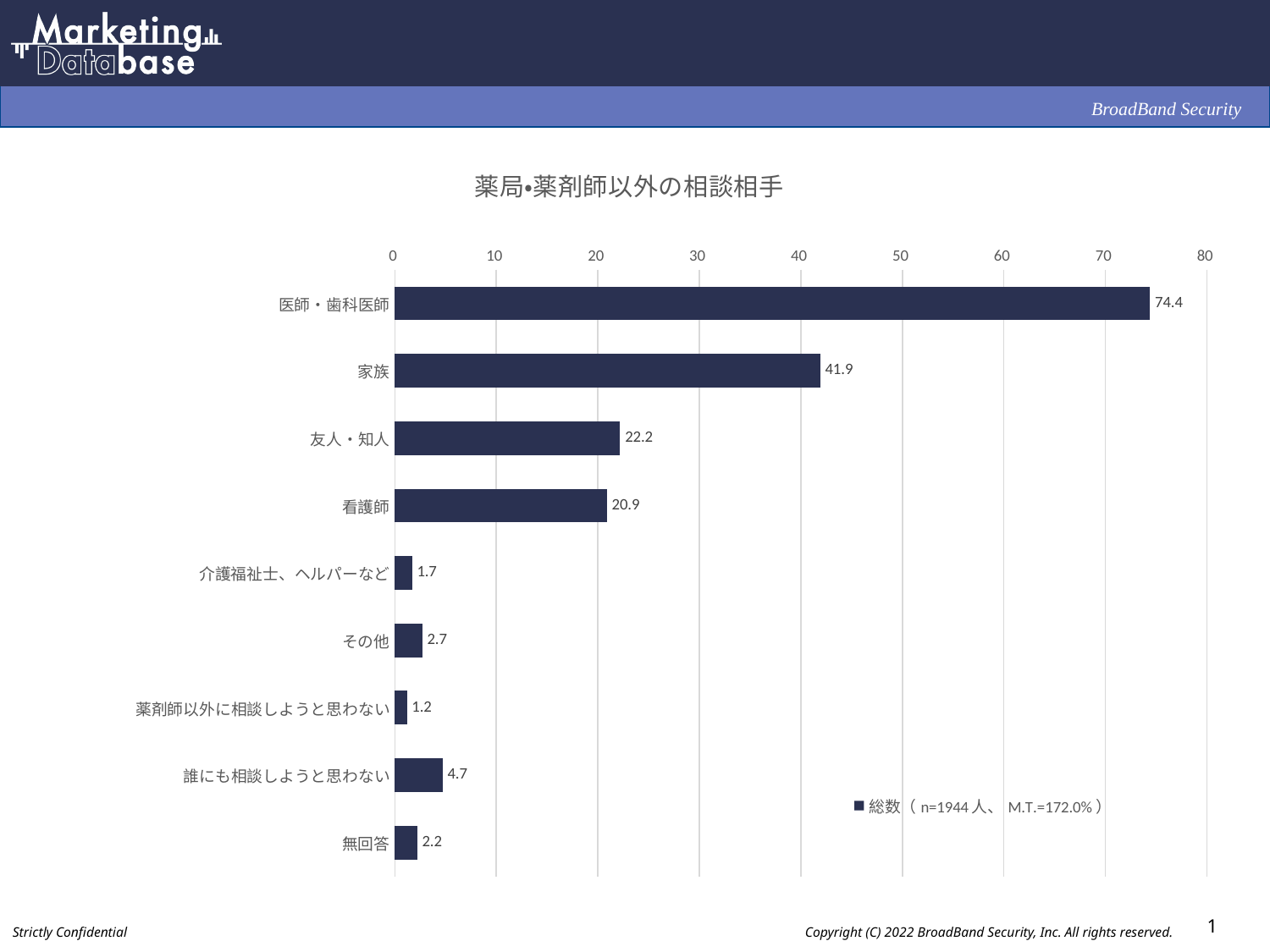
What is the difference between the values for 医師・歯科医師 and 家族? 32.5 What is the value for 誰にも相談しようと思わない? 4.7 Which category has the lowest value? 薬剤師以外に相談しようと思わない What is the value for 医師・歯科医師? 74.4 How many categories are shown in the chart? 9 Is the value for 家族 greater or less than 40? greater What kind of chart is shown on the slide? bar chart What is the value for 看護師? 20.9 Which is larger, the value for 友人・知人 or the value for 看護師? 友人・知人 What is the value for 家族? 41.9 Which category has the highest value? 医師・歯科医師 What is the title of the chart? 薬局•薬剤師以外の相談相手